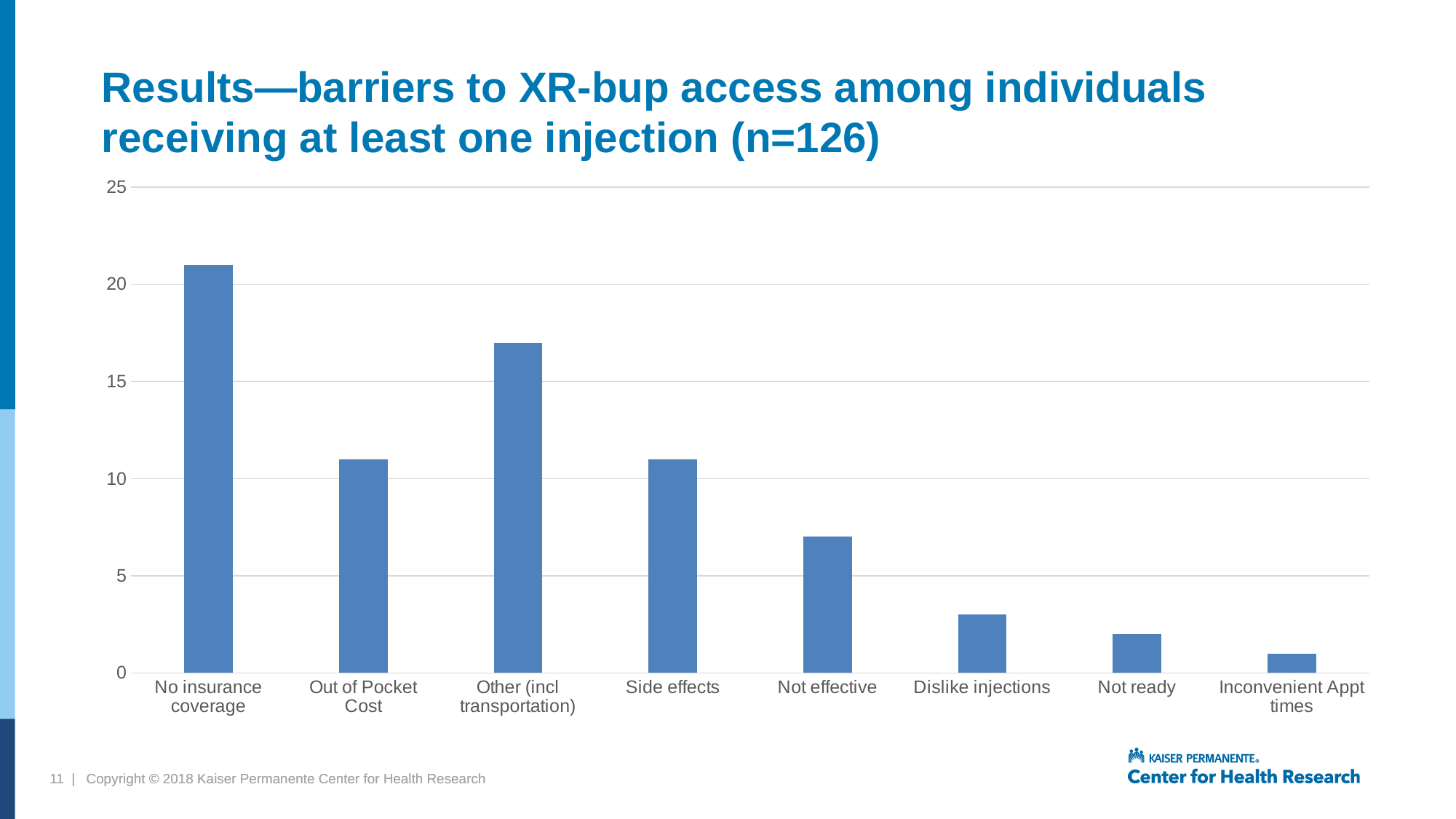
Is the value for No insurance coverage greater or less than 20? greater Which is larger, the value for Not ready or the value for Not effective? Not effective Which barrier has the lowest value? Inconvenient Appt times Is the value for Not effective greater or less than 10? less Is the value for Other (incl transportation) greater or less than 15? greater What is the sample size (n) stated in the chart title? 126 How many barrier categories are shown on the x axis? 8 Which barrier has the highest value? No insurance coverage What kind of chart is shown on the slide? bar chart Which is larger, the value for Other (incl transportation) or the value for Side effects? Other (incl transportation)